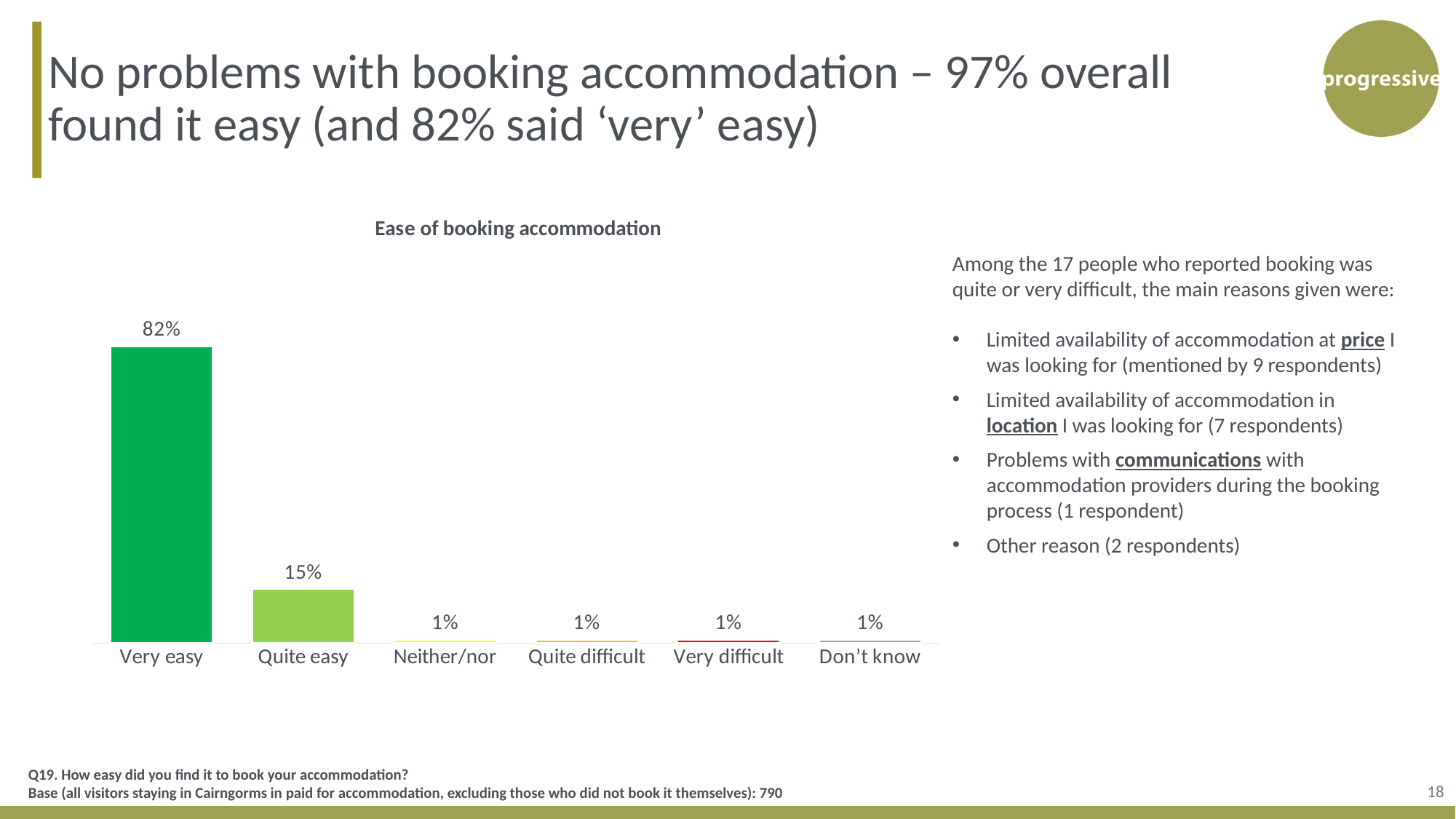
Which category has the highest value in the 'Ease of booking accommodation' chart? Very easy What is the difference in percentage points between 'Very easy' and 'Quite easy'? 67 Do the values generally rise or fall moving from 'Very easy' to 'Don't know' along the x axis? Fall What kind of chart is used to show ease of booking accommodation? Bar chart Which is larger, the value for 'Quite easy' or the value for 'Neither/nor'? Quite easy What is the title of the chart on the slide? Ease of booking accommodation How many categories are shown on the x axis of the 'Ease of booking accommodation' chart? 6 What percentage of respondents said booking accommodation was 'Quite easy'? 15% What percentage of respondents answered 'Don't know' about ease of booking accommodation? 1% What percentage of respondents said booking accommodation was 'Very easy'? 82% What percentage of respondents said booking accommodation was 'Very difficult'? 1% What is the combined percentage for 'Very easy' and 'Quite easy'? 97%